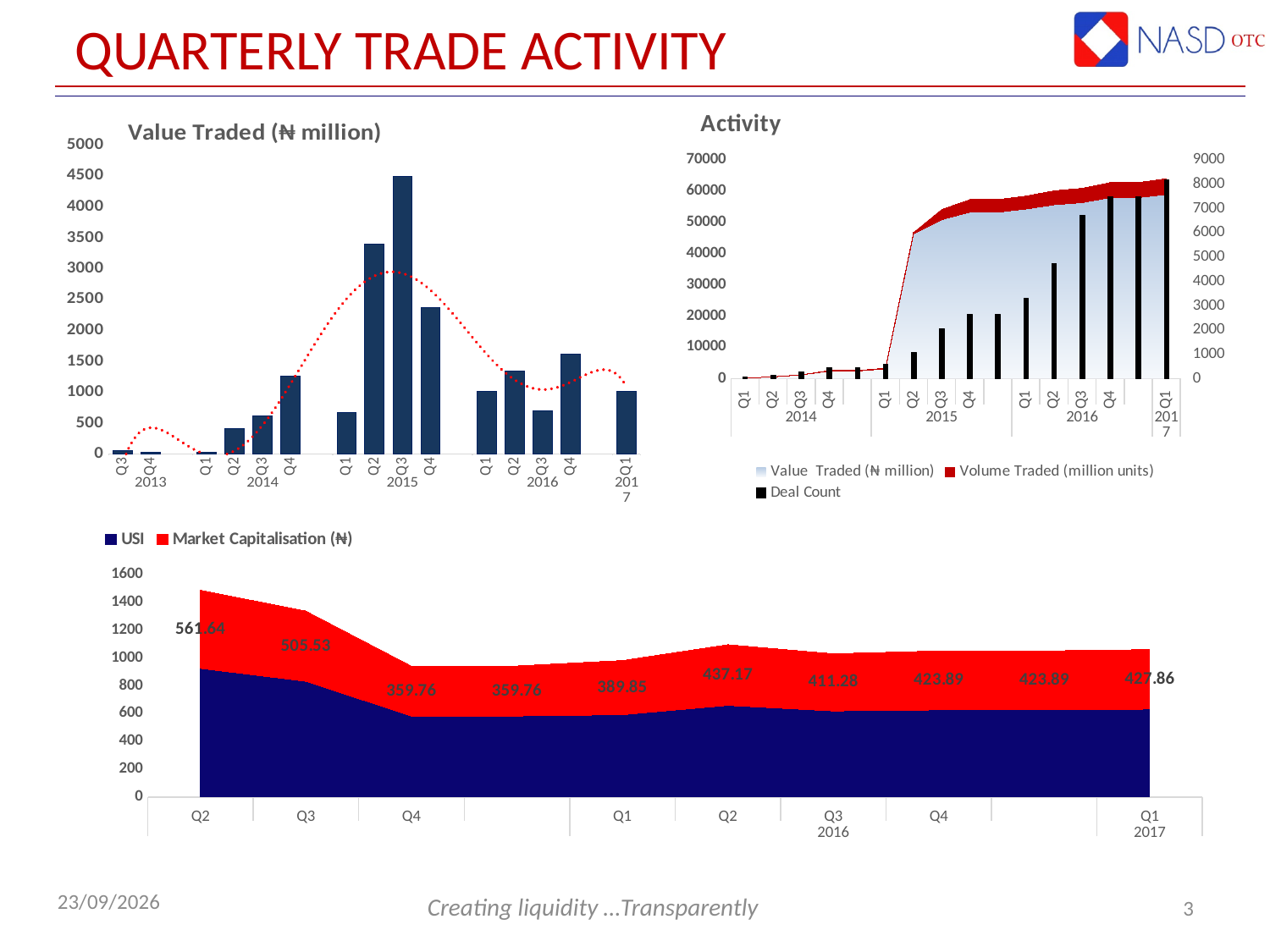
In the 'Activity' chart, does the Deal Count generally rise or fall from Q1 2014 to Q1 2017? Rise What kind of chart is the 'Value Traded (₦ million)' chart? Bar chart In the 'Value Traded (₦ million)' chart, which is larger: the value for Q3 2015 or Q4 2015? Q3 2015 How many series does the legend of the 'Activity' chart list? 3 In the 'Value Traded (₦ million)' chart, which quarter has the highest value traded? Q3 2015 In the 'Value Traded (₦ million)' chart, is the value for Q2 2015 greater or less than 3000? greater In the bottom chart (USI and Market Capitalisation), what is the highest data label shown? 561.64 How many quarters are plotted on the x axis of the 'Activity' chart? 13 In the bottom chart (USI and Market Capitalisation), what data label is shown for Q1 2017? 427.86 In the bottom chart (USI and Market Capitalisation), what is the difference between the first two data labels, 561.64 and 505.53? 56.11 In the 'Value Traded (₦ million)' chart, is the value for Q3 2016 greater or less than 1000? less In the bottom chart (USI and Market Capitalisation), what data label is shown for Q2 2016? 437.17